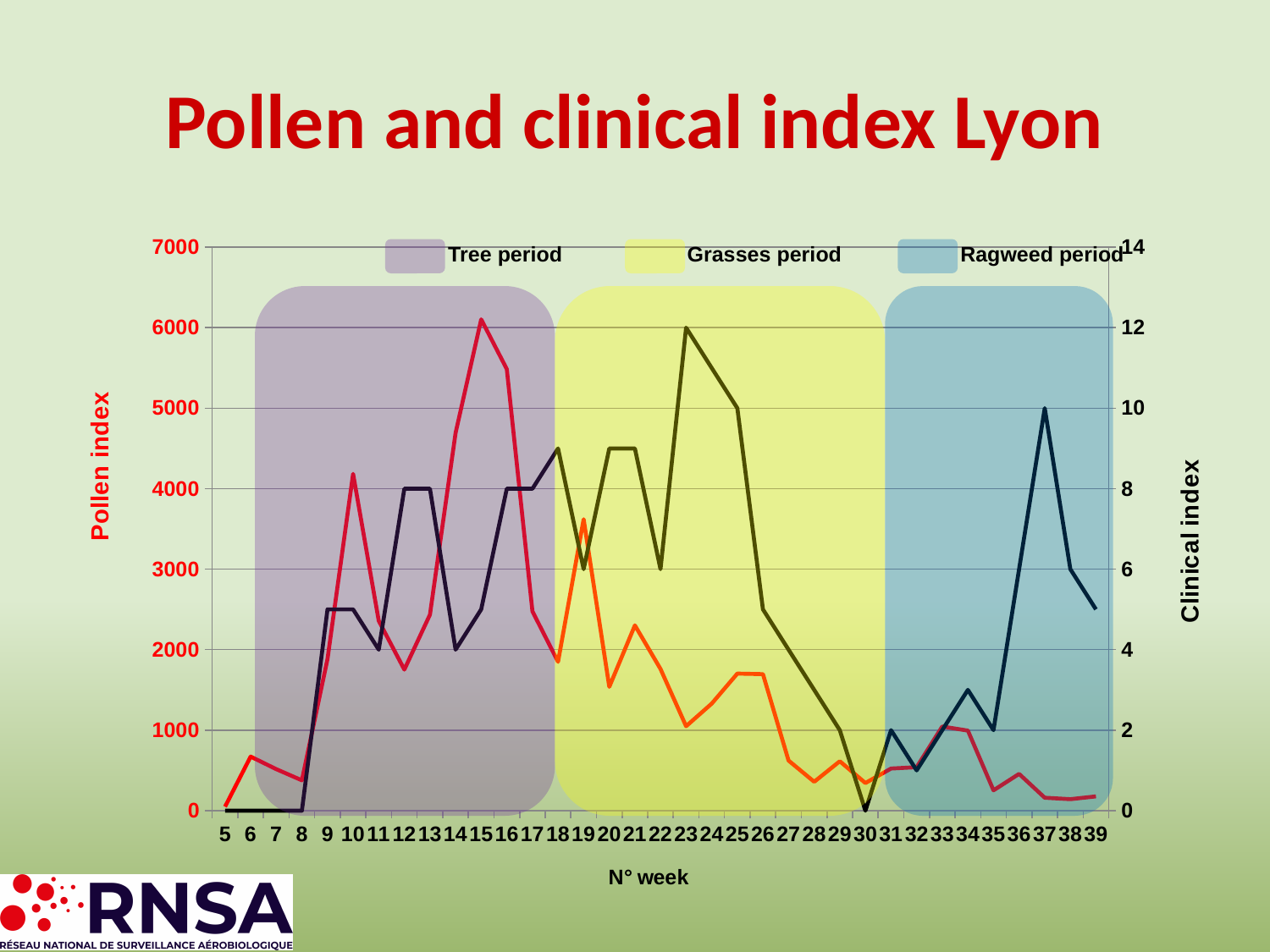
Is the clinical index at week 30 greater or less than 2? less Is the pollen index at week 15 greater or less than 5000? greater Is the clinical index at week 37 greater or less than 8? greater Which legend entry is shown with a yellow shaded area? Grasses period How many entries does the chart legend list? 3 What kind of chart is shown on the slide? line chart At which week does the clinical index reach its highest value? 23 Which week has the larger pollen index, week 10 or week 11? week 10 How many week numbers are shown along the x axis? 35 What is the title of the chart? Pollen and clinical index Lyon At which week does the pollen index reach its highest value? 15